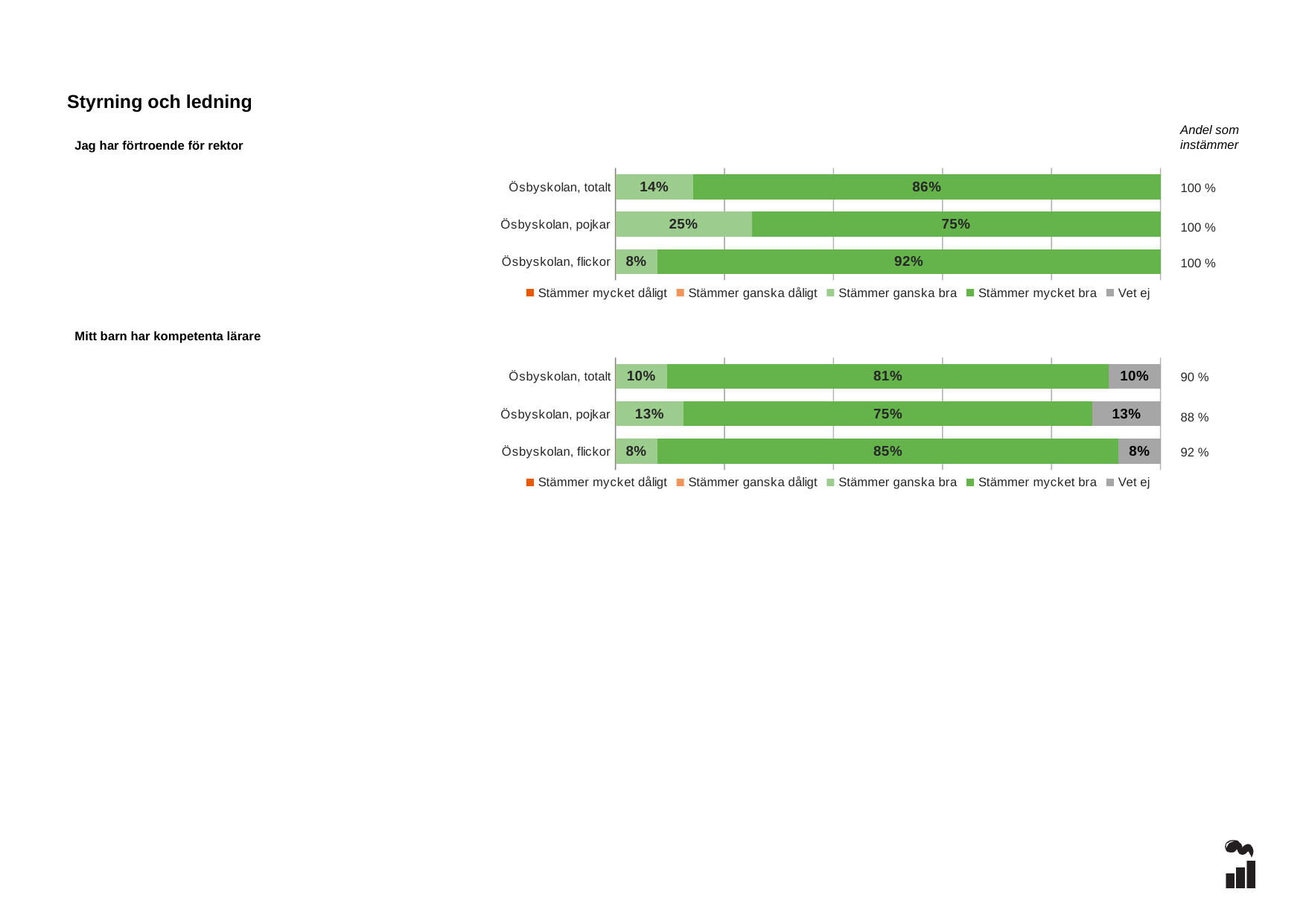
In the chart 'Jag har förtroende för rektor', what is the value of 'Stämmer ganska bra' for Ösbyskolan, pojkar? 25% How many categories are shown in the chart 'Mitt barn har kompetenta lärare'? 3 In the chart 'Jag har förtroende för rektor', which category has the lowest 'Stämmer ganska bra' value? Ösbyskolan, flickor In the chart 'Jag har förtroende för rektor', what is the difference between the 'Stämmer mycket bra' values for Ösbyskolan, flickor and Ösbyskolan, pojkar? 17% In the chart 'Mitt barn har kompetenta lärare', what is the 'Stämmer mycket bra' value for Ösbyskolan, totalt? 81% What kind of chart is 'Jag har förtroende för rektor'? Stacked bar chart In the chart 'Jag har förtroende för rektor', what is the value of 'Stämmer mycket bra' for Ösbyskolan, flickor? 92% How many series does the legend of the chart 'Jag har förtroende för rektor' list? 5 In the chart 'Mitt barn har kompetenta lärare', what is the 'Vet ej' value for Ösbyskolan, pojkar? 13% In the chart 'Jag har förtroende för rektor', which category has the highest 'Stämmer mycket bra' value? Ösbyskolan, flickor In the chart 'Mitt barn har kompetenta lärare', which is larger: the 'Stämmer mycket bra' value for Ösbyskolan, flickor or for Ösbyskolan, pojkar? Ösbyskolan, flickor